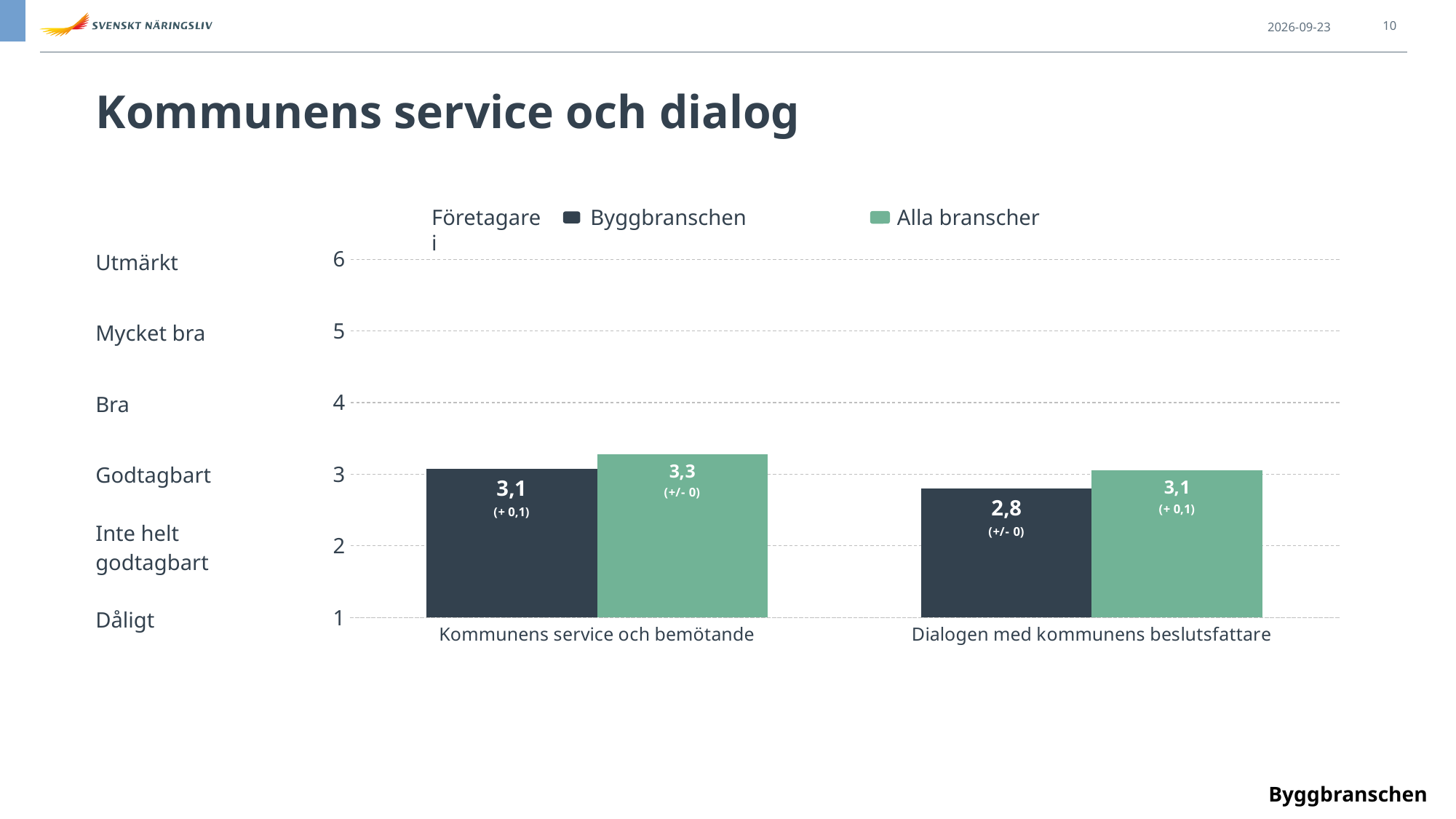
What is the value for Alla branscher in the category Dialogen med kommunens beslutsfattare? 3,1 How many series does the legend list? 2 Which series has the higher value for Dialogen med kommunens beslutsfattare, Byggbranschen or Alla branscher? Alla branscher What is the value for Alla branscher in the category Kommunens service och bemötande? 3,3 Which bar in the chart has the lowest value? Byggbranschen, Dialogen med kommunens beslutsfattare What is the value for Byggbranschen in the category Dialogen med kommunens beslutsfattare? 2,8 Which bar in the chart has the highest value? Alla branscher, Kommunens service och bemötande What is the difference between the Alla branscher and Byggbranschen values for Dialogen med kommunens beslutsfattare? 0,3 What kind of chart is shown on the slide? Bar chart What is the difference between the Alla branscher and Byggbranschen values for Kommunens service och bemötande? 0,2 What is the value for Byggbranschen in the category Kommunens service och bemötande? 3,1 How many categories are shown on the x axis? 2